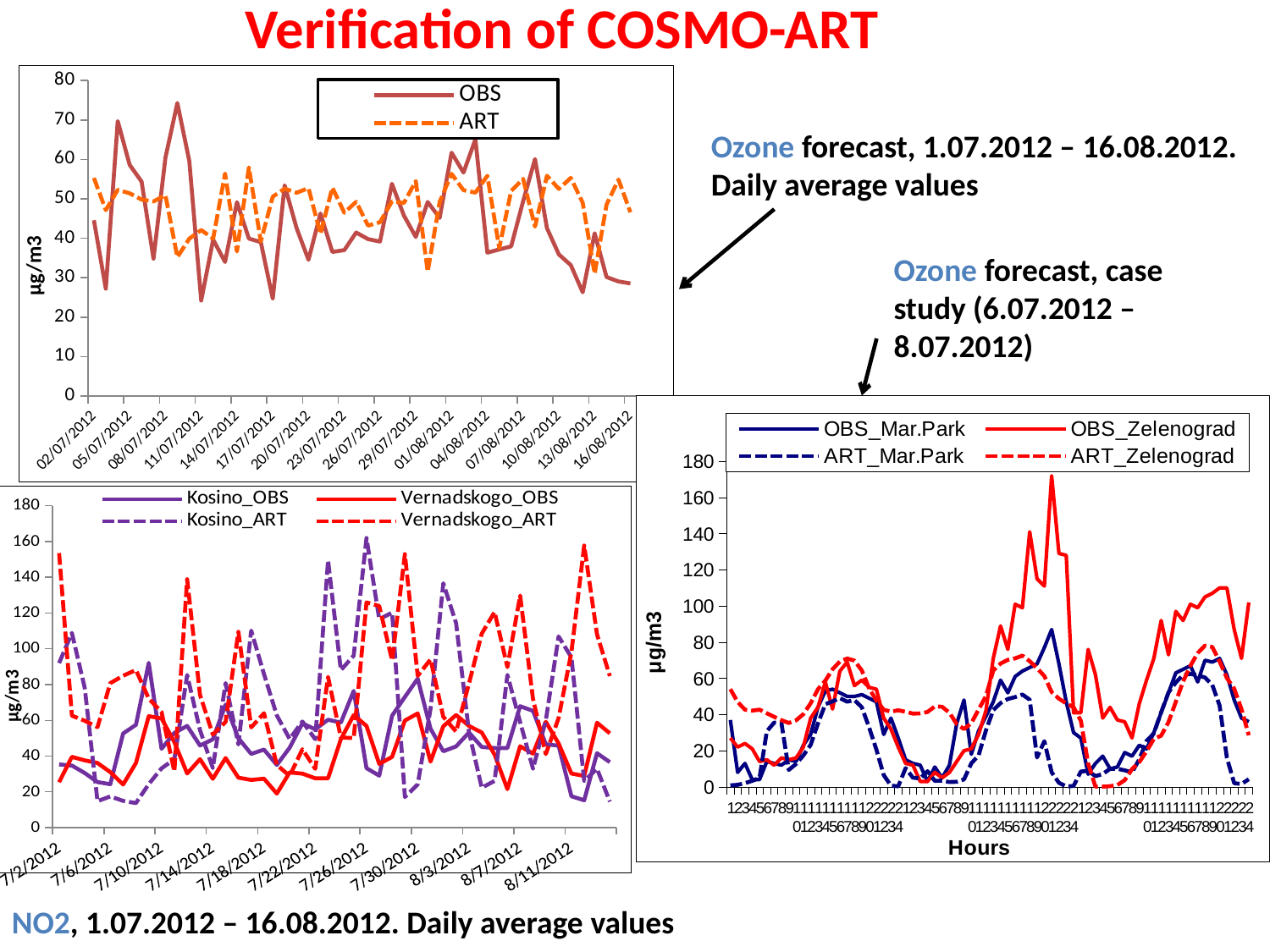
In the bottom-right chart (Ozone forecast, case study), is the highest OBS_Zelenograd value greater or less than 160? greater In the top-left chart (Ozone forecast, daily average values), is the lowest OBS value greater or less than 30? less In the top-left chart (Ozone forecast, daily average values), which series is drawn with a dashed line? ART What kind of chart is the top-left chart (Ozone forecast, daily average values)? line chart What is the x-axis title of the bottom-right chart (Ozone forecast, case study)? Hours In the top-left chart (Ozone forecast, daily average values), is the highest OBS value greater or less than 70? greater How many series does the legend of the bottom-right chart (Ozone forecast, case study) list? 4 How many series does the legend of the bottom-left chart (NO2 daily average values) list? 4 How many series does the legend of the top-left chart (Ozone forecast, daily average values) list? 2 What is the y-axis label of the top-left chart (Ozone forecast, daily average values)? µg/m3